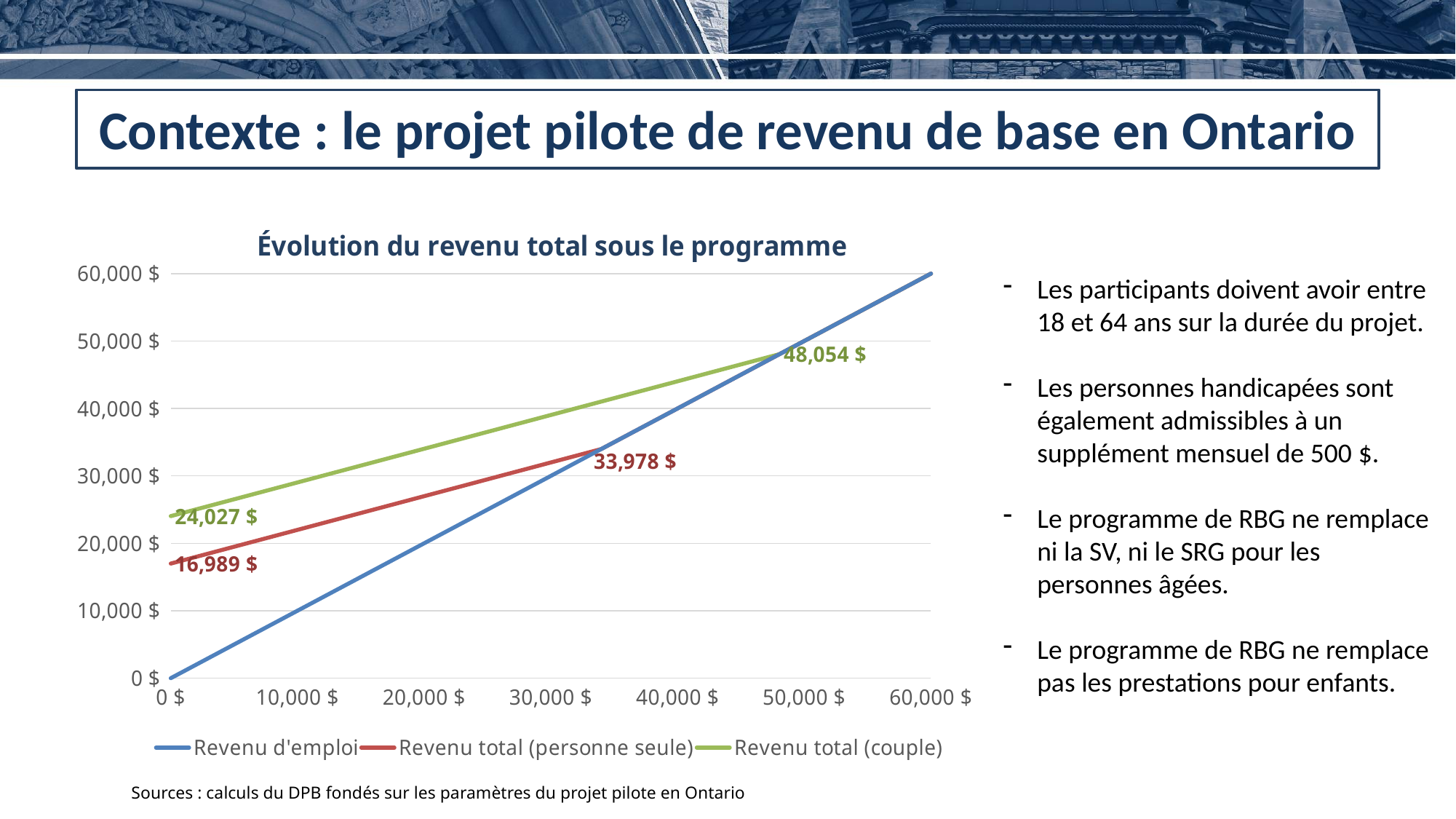
What is the value of Revenu total (couple) when Revenu d'emploi is 0 $? 24,027 $ Which series has the highest value at 0 $ of Revenu d'emploi? Revenu total (couple) What is the labelled value at the end of the Revenu total (personne seule) line? 33,978 $ What kind of chart is shown on the slide? line chart What is the labelled value at the end of the Revenu total (couple) line? 48,054 $ Do the lines rise or fall as Revenu d'emploi increases along the x axis? rise How many series does the chart legend list? 3 Is the value of Revenu total (personne seule) at 20,000 $ of Revenu d'emploi greater or less than 30,000 $? less What is the value of Revenu total (personne seule) when Revenu d'emploi is 0 $? 16,989 $ Which series has the lowest value at 0 $ of Revenu d'emploi? Revenu d'emploi What is the difference between Revenu total (couple) and Revenu total (personne seule) at 0 $ of Revenu d'emploi? 7,038 $ What is the title of the chart? Évolution du revenu total sous le programme